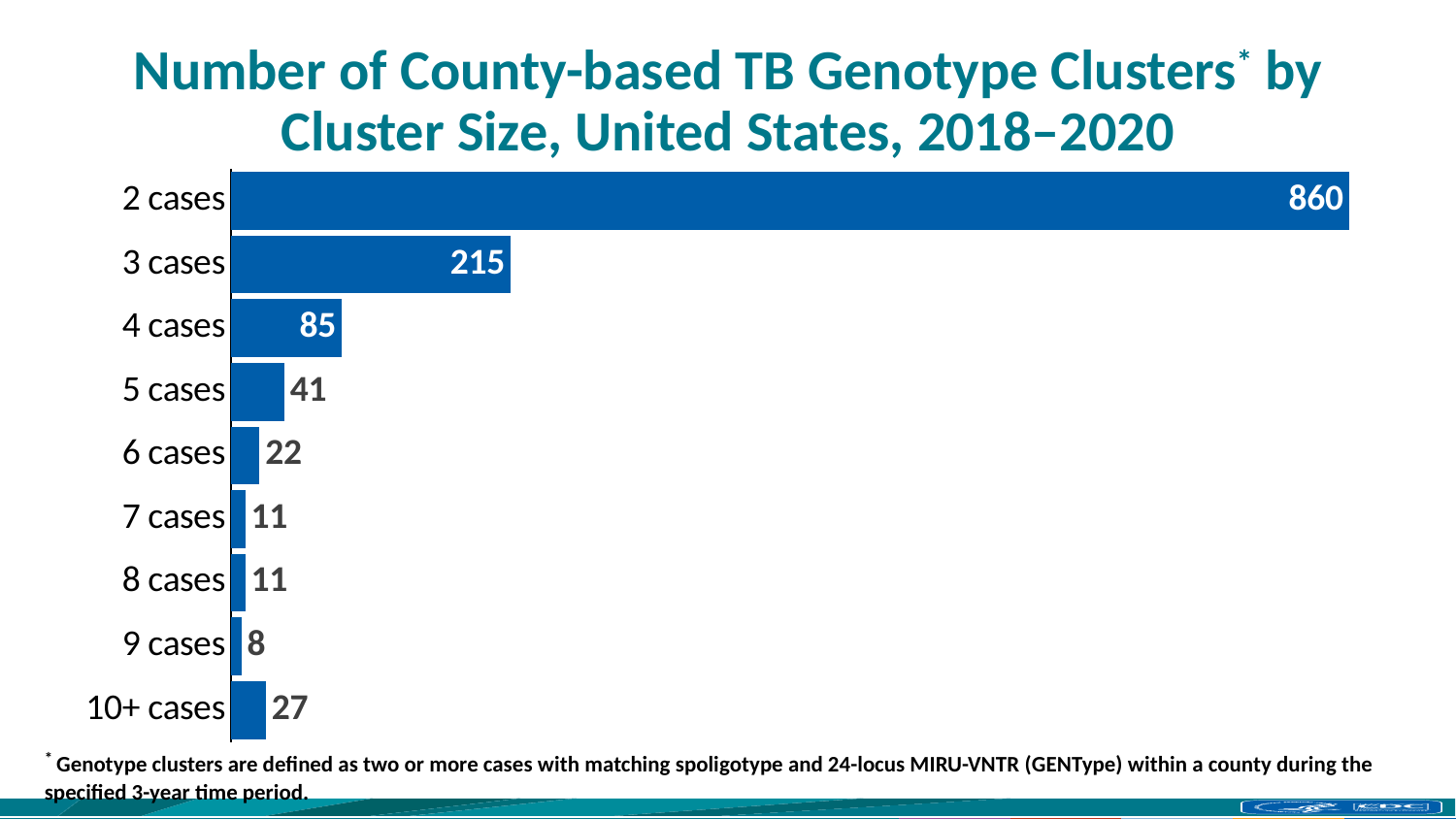
Which cluster size has the highest number of clusters? 2 cases How many cluster size categories are shown in the chart? 9 How many clusters had 10+ cases? 27 How many more clusters had 4 cases than 5 cases? 44 What type of chart is shown on the slide? Bar chart What is the difference between the number of clusters with 2 cases and the number with 3 cases? 645 Which has more clusters: 10+ cases or 6 cases? 10+ cases What is the number of clusters with 3 cases? 215 Which cluster size has the lowest number of clusters? 9 cases What time period does the chart title cover? 2018–2020 How many county-based TB genotype clusters had 2 cases? 860 What is the value shown for 6 cases? 22